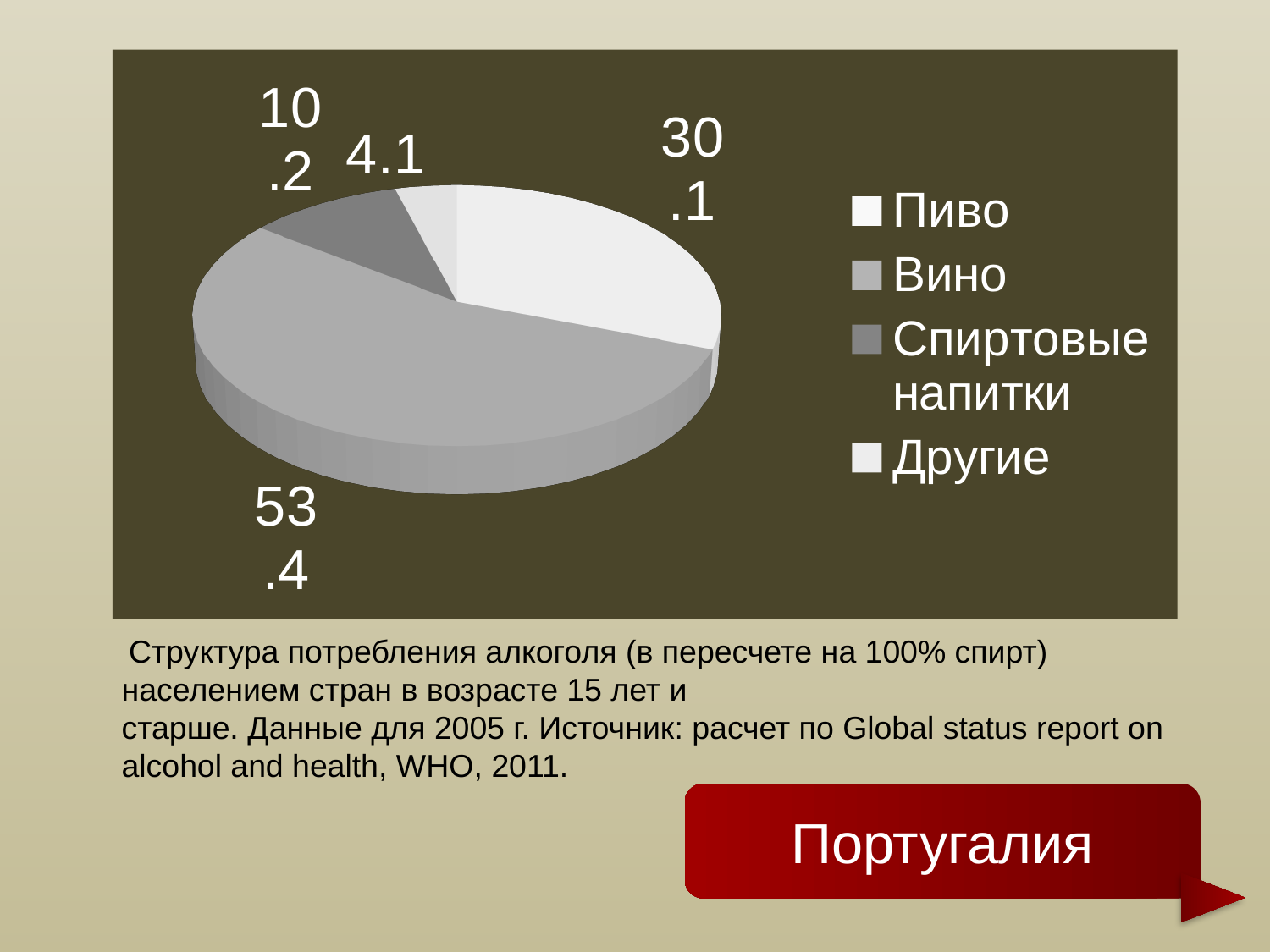
What kind of chart is shown on the slide? Pie chart What is the value shown for Другие in the pie chart? 4.1 Which category has the largest slice in the pie chart? Вино Which country is named in the red box on the slide? Португалия How many slices does the pie chart have? 4 Which is larger, the value for Пиво or the value for Спиртовые напитки? Пиво What is the value shown for Спиртовые напитки in the pie chart? 10.2 Which category has the smallest slice in the pie chart? Другие What is the difference between the values for Спиртовые напитки and Другие? 6.1 What is the difference between the values for Вино and Пиво? 23.3 What is the value shown for Вино in the pie chart? 53.4 What is the value shown for Пиво in the pie chart? 30.1